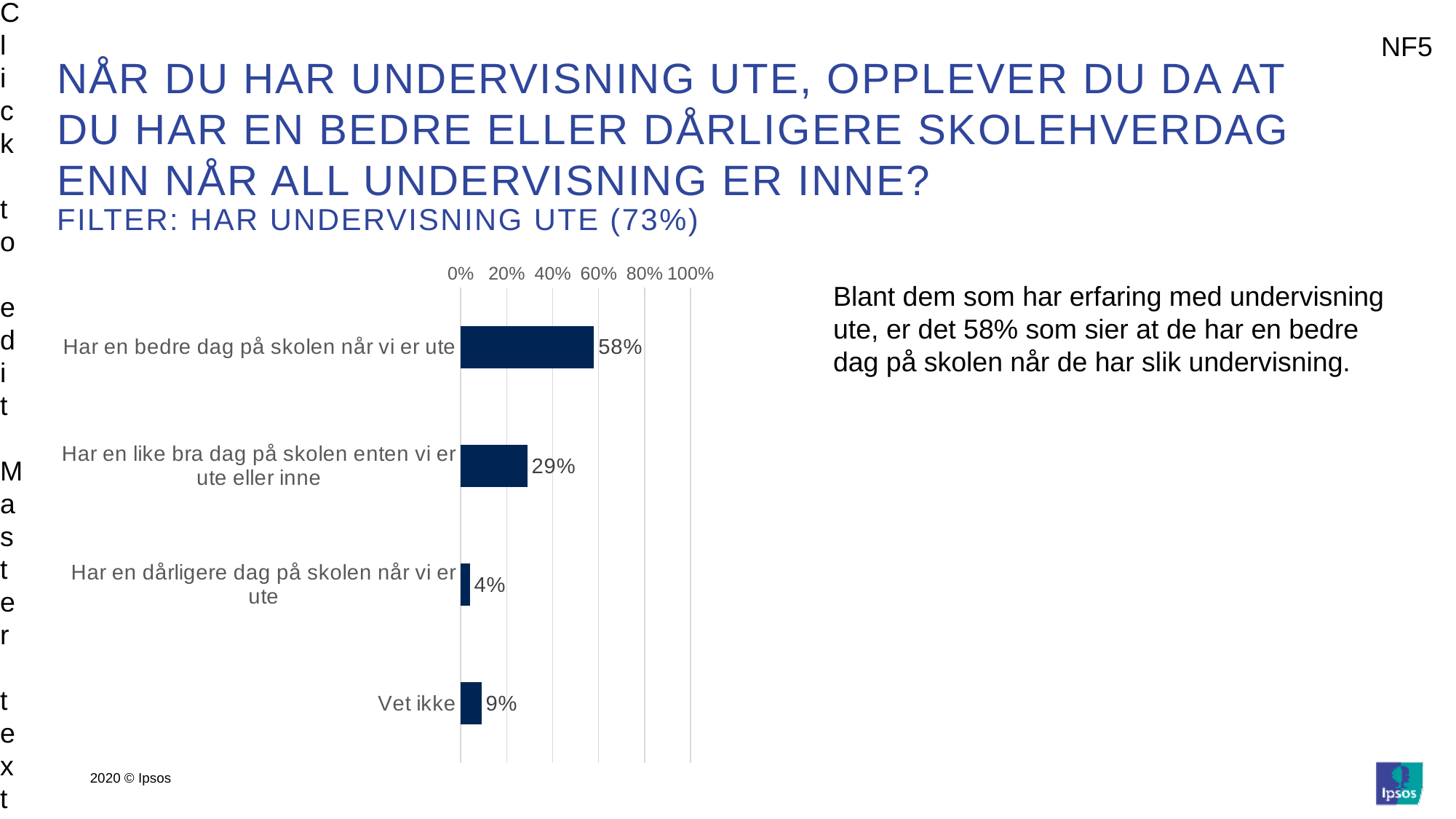
What is the value for "Har en like bra dag på skolen enten vi er ute eller inne"? 29% How many categories are shown in the chart? 4 What is the value for "Vet ikke"? 9% What is the value for "Har en bedre dag på skolen når vi er ute"? 58% What kind of chart is shown on the slide? Bar chart Is the value for "Har en like bra dag på skolen enten vi er ute eller inne" greater or less than 40%? less What is the difference between the values for "Har en bedre dag på skolen når vi er ute" and "Har en like bra dag på skolen enten vi er ute eller inne"? 29% Which category has the lowest value? Har en dårligere dag på skolen når vi er ute What is the filter stated in the subtitle of the slide? Har undervisning ute (73%) Which category has the highest value? Har en bedre dag på skolen når vi er ute What is the value for "Har en dårligere dag på skolen når vi er ute"? 4% Which is larger, the value for "Vet ikke" or the value for "Har en dårligere dag på skolen når vi er ute"? Vet ikke